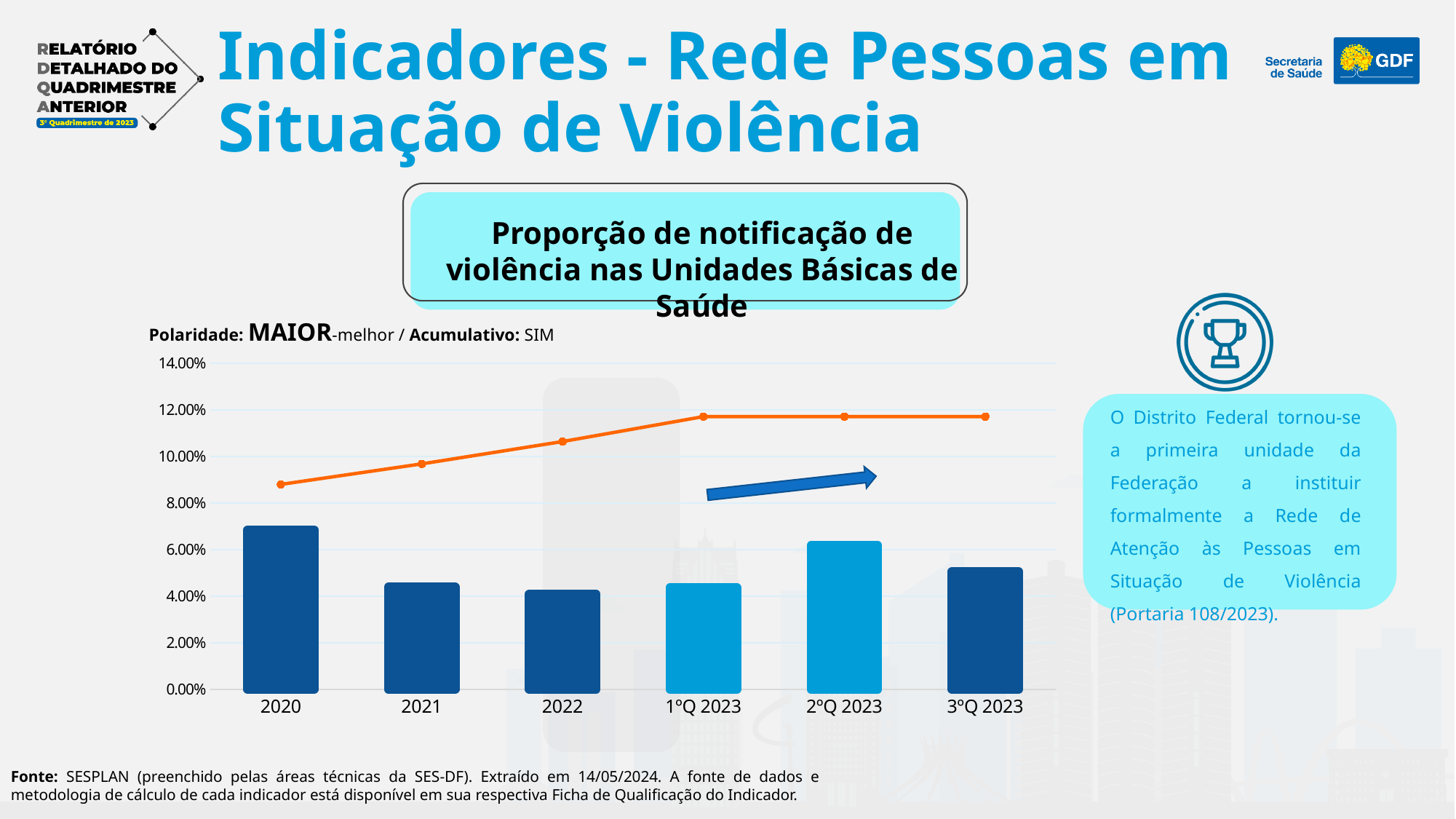
Which bar is taller, 2020 or 2021? 2020 Which bar is taller, 2ºQ 2023 or 3ºQ 2023? 2ºQ 2023 Does the orange line rise or fall from 2020 to 1ºQ 2023? rise What kind of chart is shown on the slide? A combined bar and line chart Which category has the tallest bar in the chart? 2020 What is the title of the indicator shown in the chart? Proporção de notificação de violência nas Unidades Básicas de Saúde How many categories are shown on the x axis of the chart? 6 Is the line value for 2020 greater or less than 10.00%? less Is the bar value for 2020 greater or less than 6.00%? greater